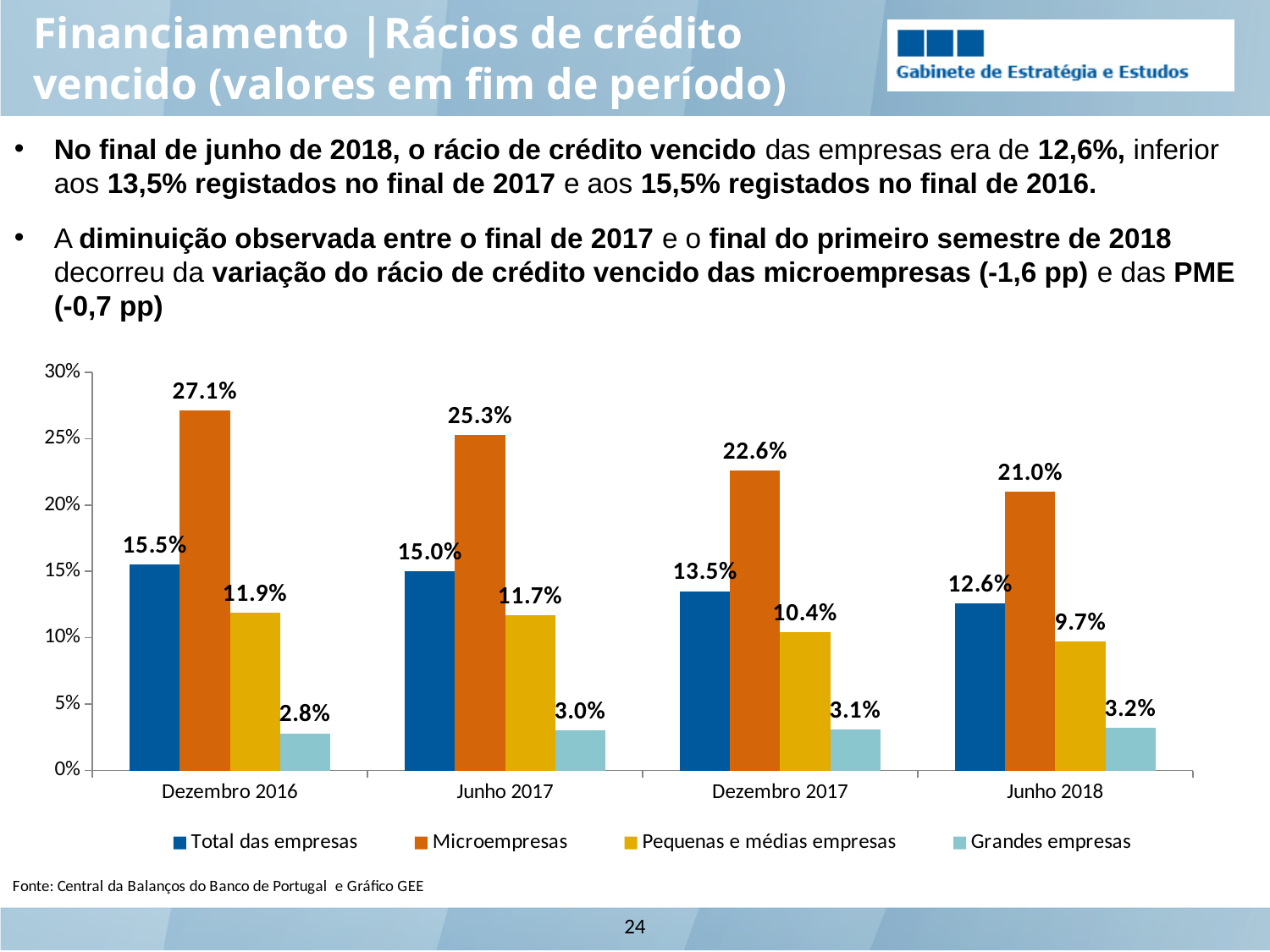
What is the value for Pequenas e médias empresas in Dezembro 2017? 10.4% What is the value for Total das empresas in Junho 2018? 12.6% What kind of chart is shown on the slide? Bar chart What is the value for Grandes empresas in Junho 2017? 3.0% What is the difference between the Microempresas values in Dezembro 2017 and Junho 2018? 1.6% How many series does the legend list? 4 What is the value for Microempresas in Dezembro 2016? 27.1% Which is larger: Total das empresas in Dezembro 2016 or Total das empresas in Junho 2017? Dezembro 2016 How many periods are shown on the x axis? 4 In which period is the value for Microempresas highest? Dezembro 2016 Do the values for Grandes empresas rise or fall from Dezembro 2016 to Junho 2018? Rise Which series has the lowest value in Junho 2018? Grandes empresas